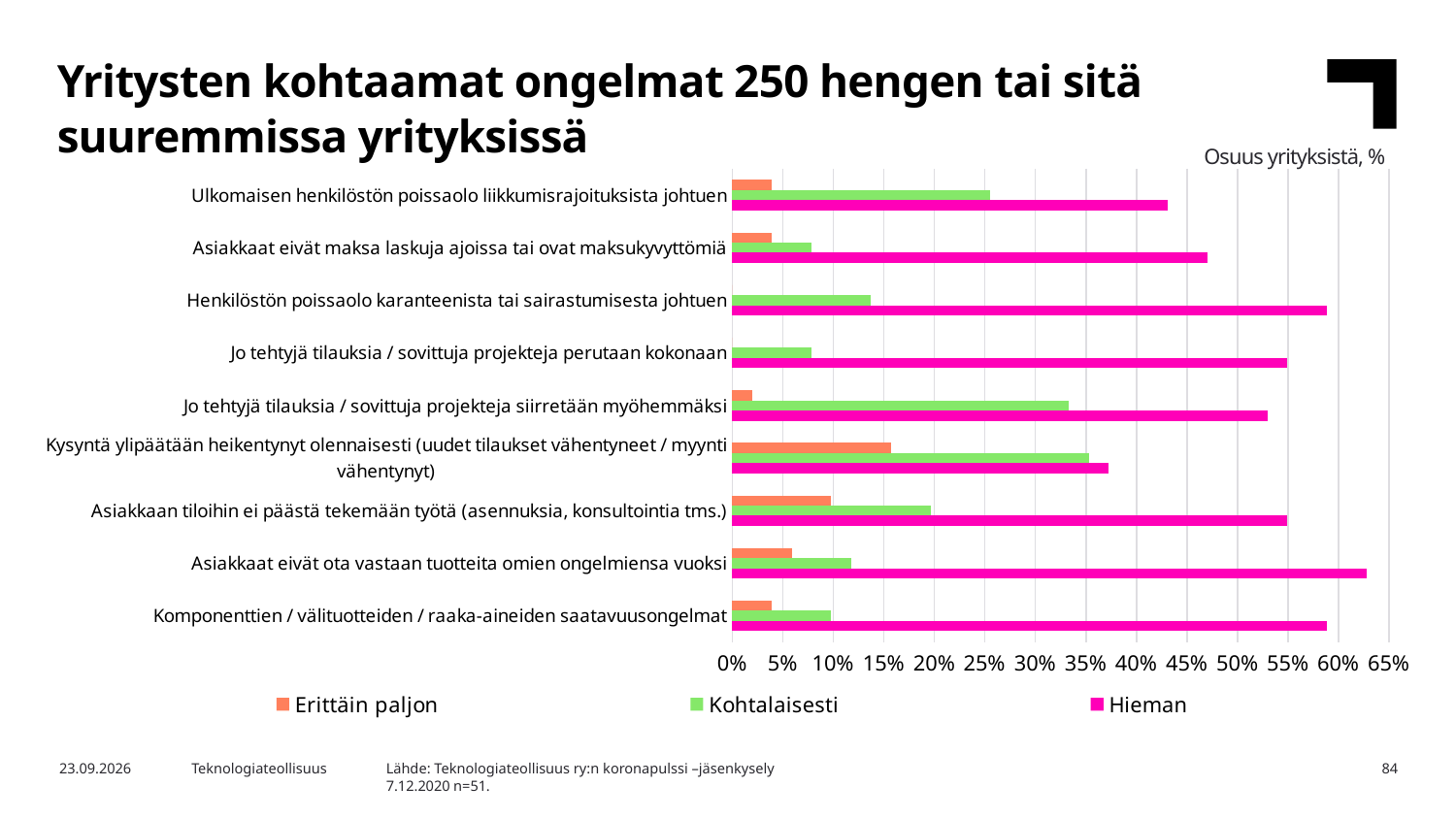
Which category has the highest value for the 'Erittäin paljon' series? Kysyntä ylipäätään heikentynyt olennaisesti (uudet tilaukset vähentyneet / myynti vähentynyt) Which is larger: the 'Hieman' value for 'Asiakkaat eivät ota vastaan tuotteita omien ongelmiensa vuoksi' or for 'Kysyntä ylipäätään heikentynyt olennaisesti'? Asiakkaat eivät ota vastaan tuotteita omien ongelmiensa vuoksi Is the 'Erittäin paljon' value for 'Asiakkaan tiloihin ei päästä tekemään työtä (asennuksia, konsultointia tms.)' greater or less than 15%? less How many series does the legend list? 3 Is the 'Hieman' value for 'Henkilöstön poissaolo karanteenista tai sairastumisesta johtuen' greater or less than 55%? greater Is the 'Kohtalaisesti' value for 'Ulkomaisen henkilöstön poissaolo liikkumisrajoituksista johtuen' greater or less than 20%? greater What kind of chart is shown on the slide? Bar chart Which category has the highest value for the 'Hieman' series? Asiakkaat eivät ota vastaan tuotteita omien ongelmiensa vuoksi Which is larger: the 'Kohtalaisesti' value for 'Jo tehtyjä tilauksia / sovittuja projekteja siirretään myöhemmäksi' or for 'Asiakkaat eivät maksa laskuja ajoissa tai ovat maksukyvyttömiä'? Jo tehtyjä tilauksia / sovittuja projekteja siirretään myöhemmäksi Which colour represents the 'Hieman' series in the legend? Magenta (pink) How many problem categories are plotted on the chart? 9 What unit label is shown above the chart? Osuus yrityksistä, %